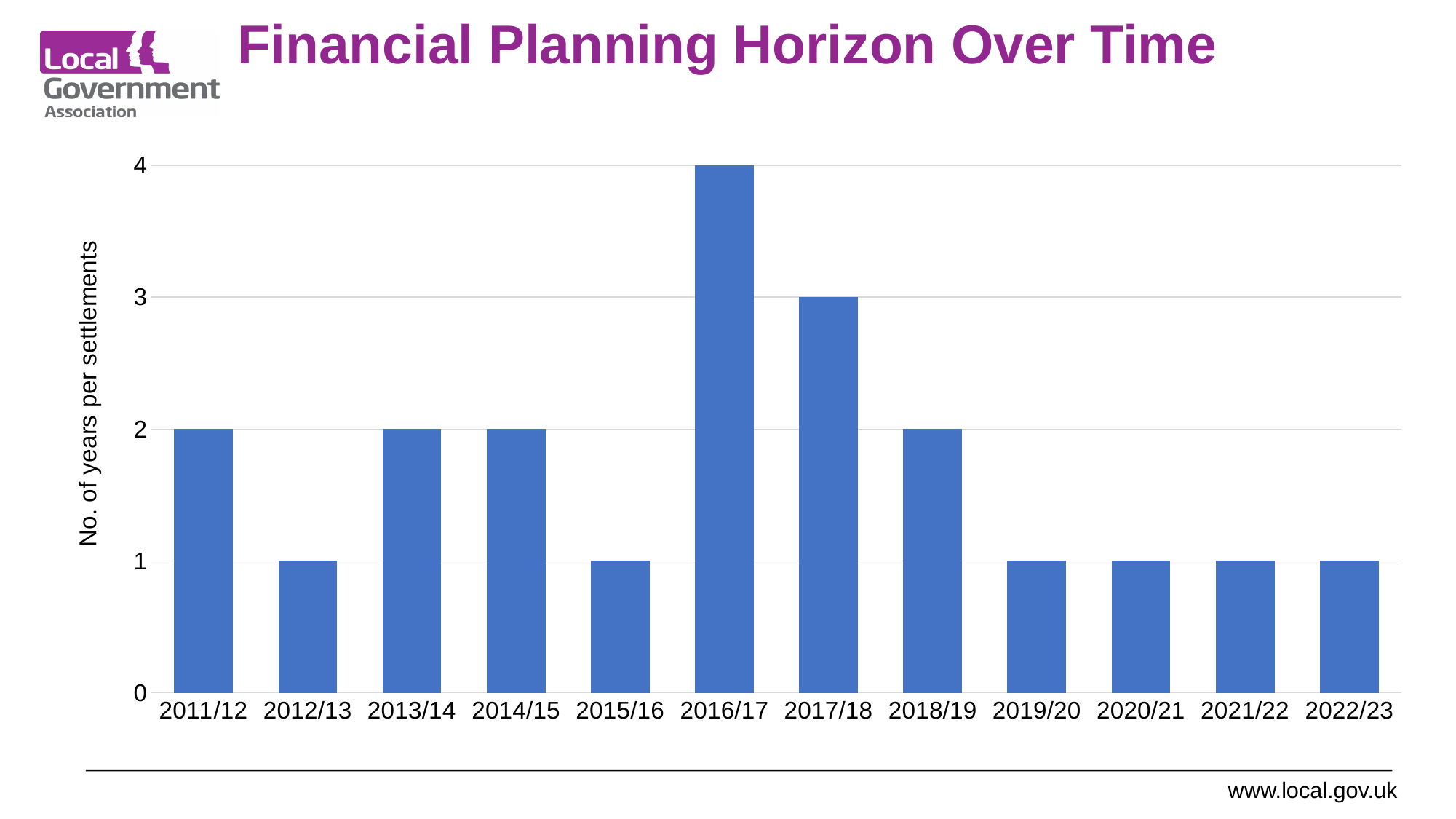
What is the label of the vertical axis? No. of years per settlements Which year has the highest value? 2016/17 Which is larger, the value for 2018/19 or the value for 2019/20? 2018/19 What kind of chart is shown on the slide? bar chart What is the value for 2016/17? 4 Is the value for 2017/18 greater or less than 2? greater What is the value for 2011/12? 2 What is the value for 2017/18? 3 What is the value for 2022/23? 1 What is the difference between the values for 2016/17 and 2017/18? 1 How many years are shown on the x axis? 12 What is the difference between the values for 2016/17 and 2015/16? 3